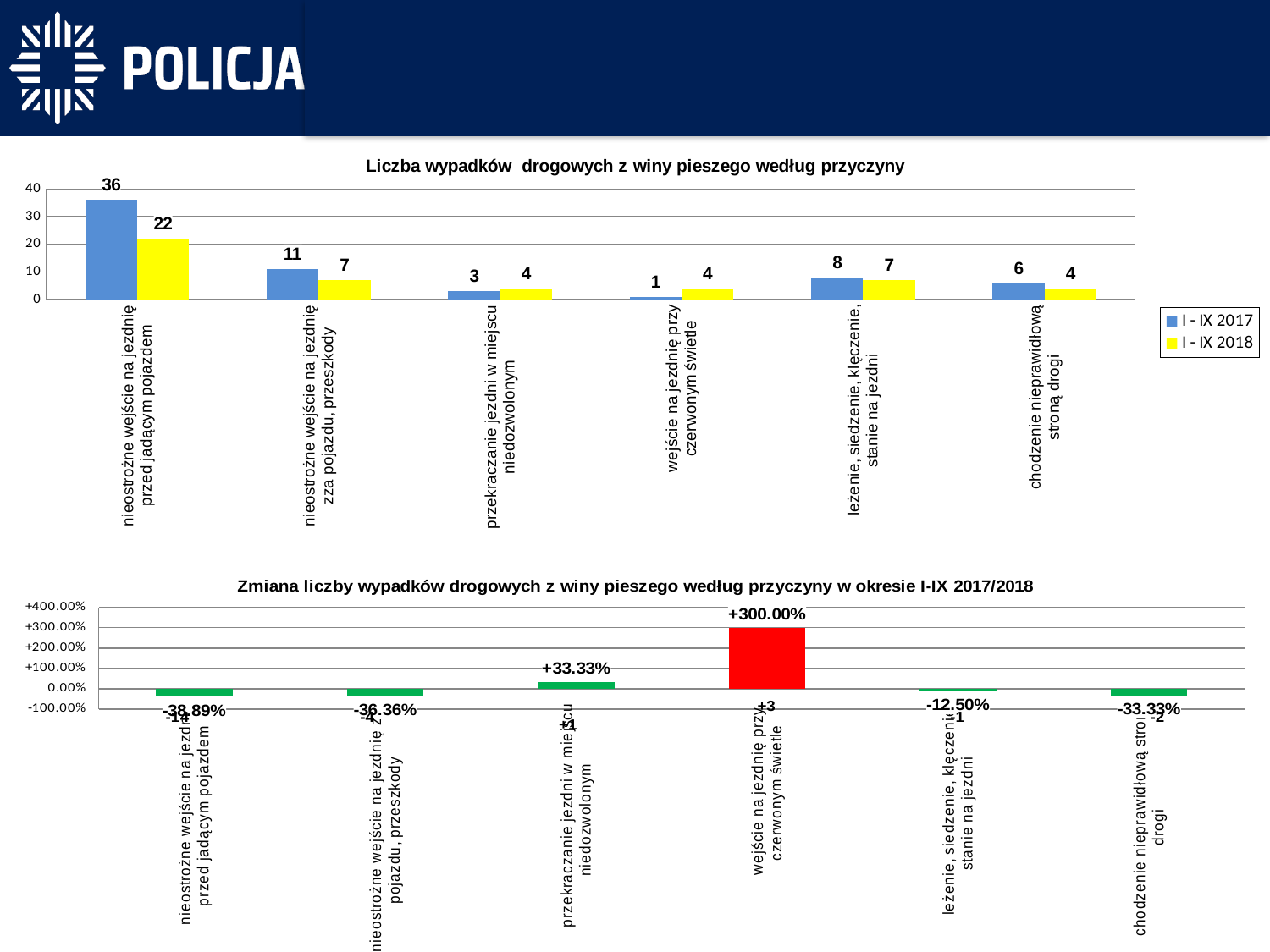
In the top chart, for 'przekraczanie jezdni w miejscu niedozwolonym', which series has the larger value, I - IX 2017 or I - IX 2018? I - IX 2018 In the top chart, what is the value for 'wejście na jezdnię przy czerwonym świetle' in the I - IX 2018 series? 4 In the top chart, what is the value for 'leżenie, siedzenie, klęczenie, stanie na jezdni' in the I - IX 2017 series? 8 In the bottom chart, what is the percentage change shown for 'leżenie, siedzenie, klęczenie, stanie na jezdni'? -12.50% How many categories are shown on the x axis of the top chart? 6 How many series does the legend of the top chart list? 2 In the top chart, what is the difference between the I - IX 2017 and I - IX 2018 values for 'nieostrożne wejście na jezdnię przed jadącym pojazdem'? 14 In the top chart 'Liczba wypadków drogowych z winy pieszego według przyczyny', what is the value for 'nieostrożne wejście na jezdnię przed jadącym pojazdem' in the I - IX 2017 series? 36 What kind of chart is the bottom chart 'Zmiana liczby wypadków drogowych z winy pieszego według przyczyny w okresie I-IX 2017/2018'? bar chart In the bottom chart, what is the percentage change shown for 'wejście na jezdnię przy czerwonym świetle'? +300.00% In the top chart, which category has the highest value in the I - IX 2018 series? nieostrożne wejście na jezdnię przed jadącym pojazdem In the top chart, which category has the lowest value in the I - IX 2017 series? wejście na jezdnię przy czerwonym świetle